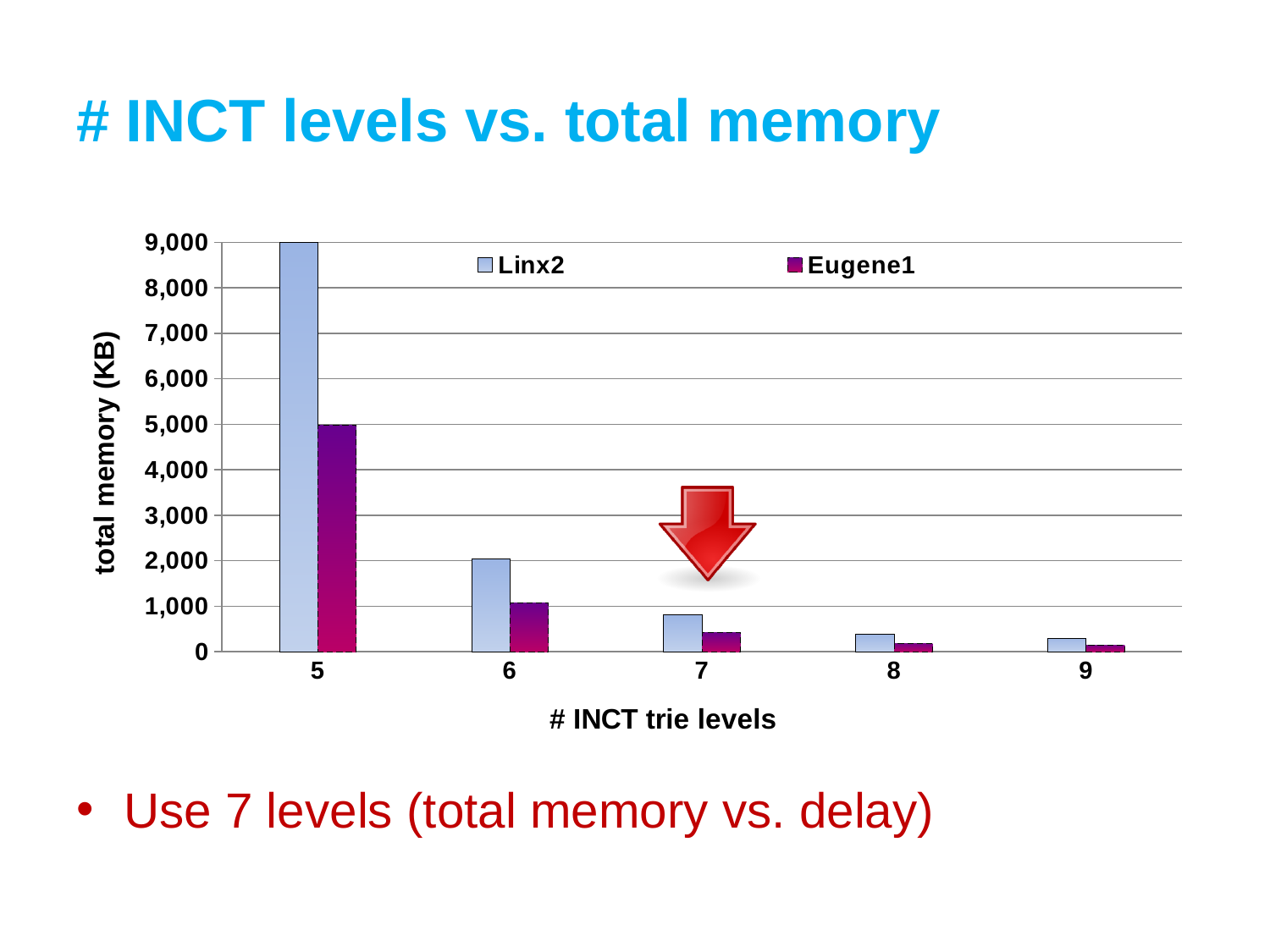
What kind of chart is shown on the slide? bar chart At which number of INCT trie levels is the Linx2 total memory highest? 5 How many INCT trie level categories are shown on the x axis? 5 Is the total memory for Eugene1 at 6 levels greater or less than 2,000? less Does the total memory rise or fall as the number of INCT trie levels increases? fall How many series does the legend list? 2 Is the total memory for Linx2 at 6 levels greater or less than 1,000? greater Which has the larger total memory at 7 levels, Linx2 or Eugene1? Linx2 At which number of INCT trie levels is the Eugene1 total memory lowest? 9 Is the total memory for Linx2 at 7 levels greater or less than 1,000? less